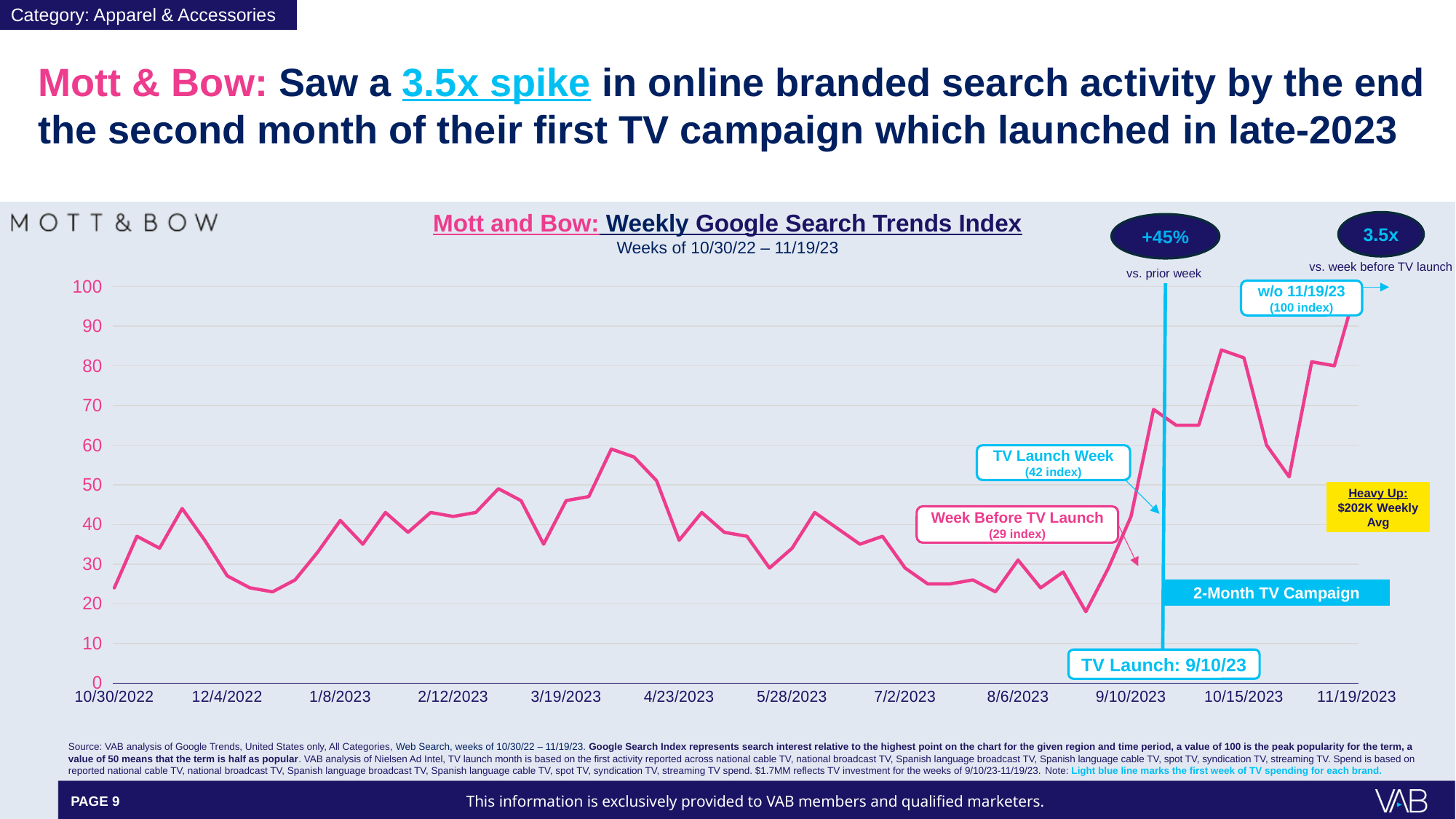
What kind of chart is shown on the slide? line chart What index value does the callout give for the week of 11/19/23? 100 Is the index value for the week of 3/19/2023 greater or less than 40? greater By how many index points does the TV Launch Week exceed the Week Before TV Launch? 13 Which is larger, the index for the TV Launch Week or the Week Before TV Launch? TV Launch Week What is the index value for the Week Before TV Launch? 29 Does the index generally rise or fall between the TV launch on 9/10/2023 and 11/19/2023? rise What is the Google Search Trends Index value for the TV Launch Week? 42 Is the index value for the week of 10/30/2022 greater or less than 30? less How many data series are plotted on the chart? 1 What percentage change vs. the prior week is shown in the callout above the TV launch line? +45% On what date did the TV launch occur according to the chart annotation? 9/10/23